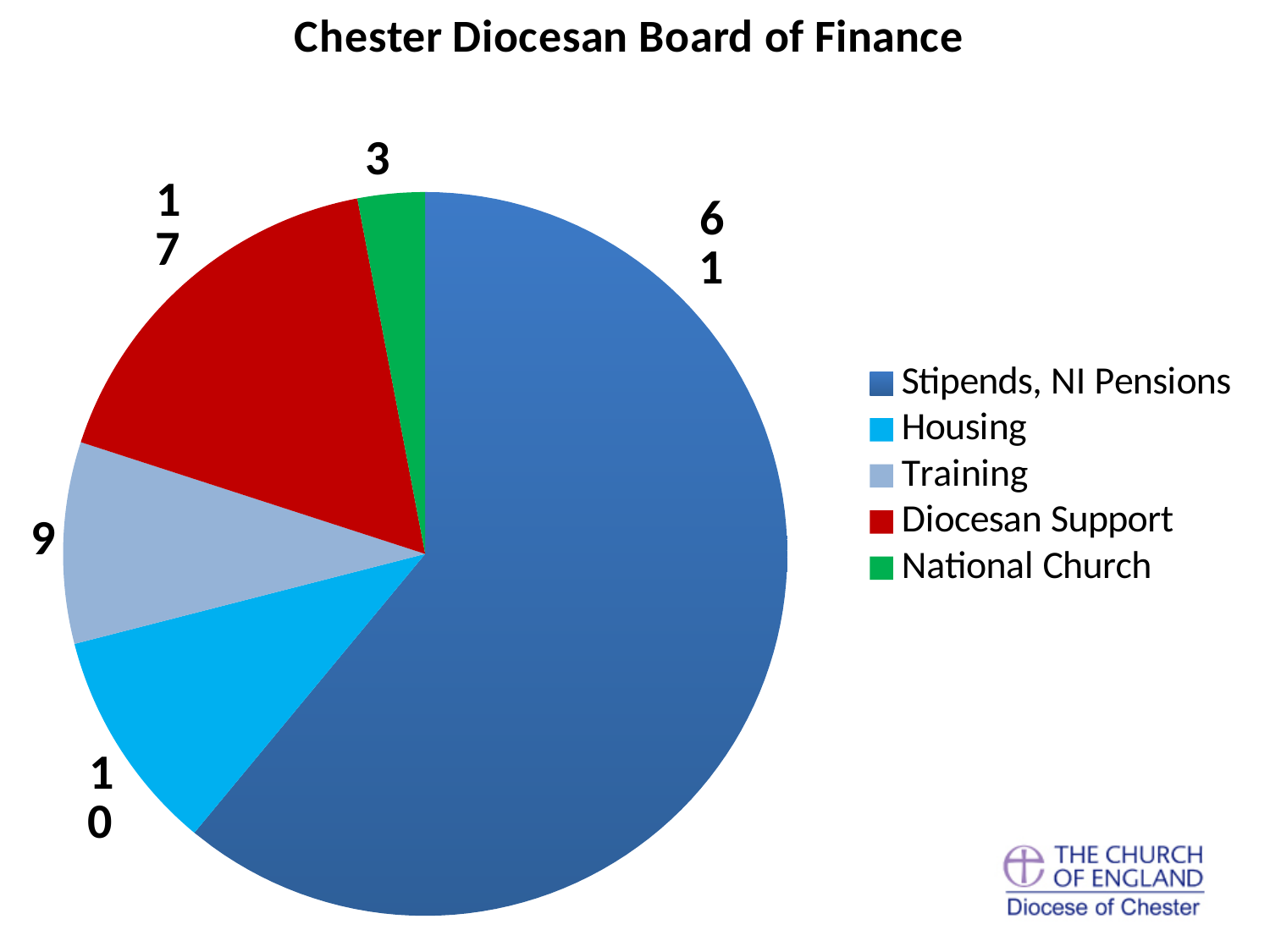
What is the value shown for National Church? 3 What is the difference between the values for Diocesan Support and Training? 8 Which category has the smallest slice of the pie? National Church Which category is shown in green in the legend? National Church What is the value shown for Stipends, NI Pensions? 61 Which is larger, the value for Housing or the value for Training? Housing What is the title of the chart? Chester Diocesan Board of Finance What type of chart is shown on the slide? pie chart What is the value shown for Diocesan Support? 17 How many slices does the pie chart have? 5 Which category has the largest slice of the pie? Stipends, NI Pensions What is the value shown for Housing? 10